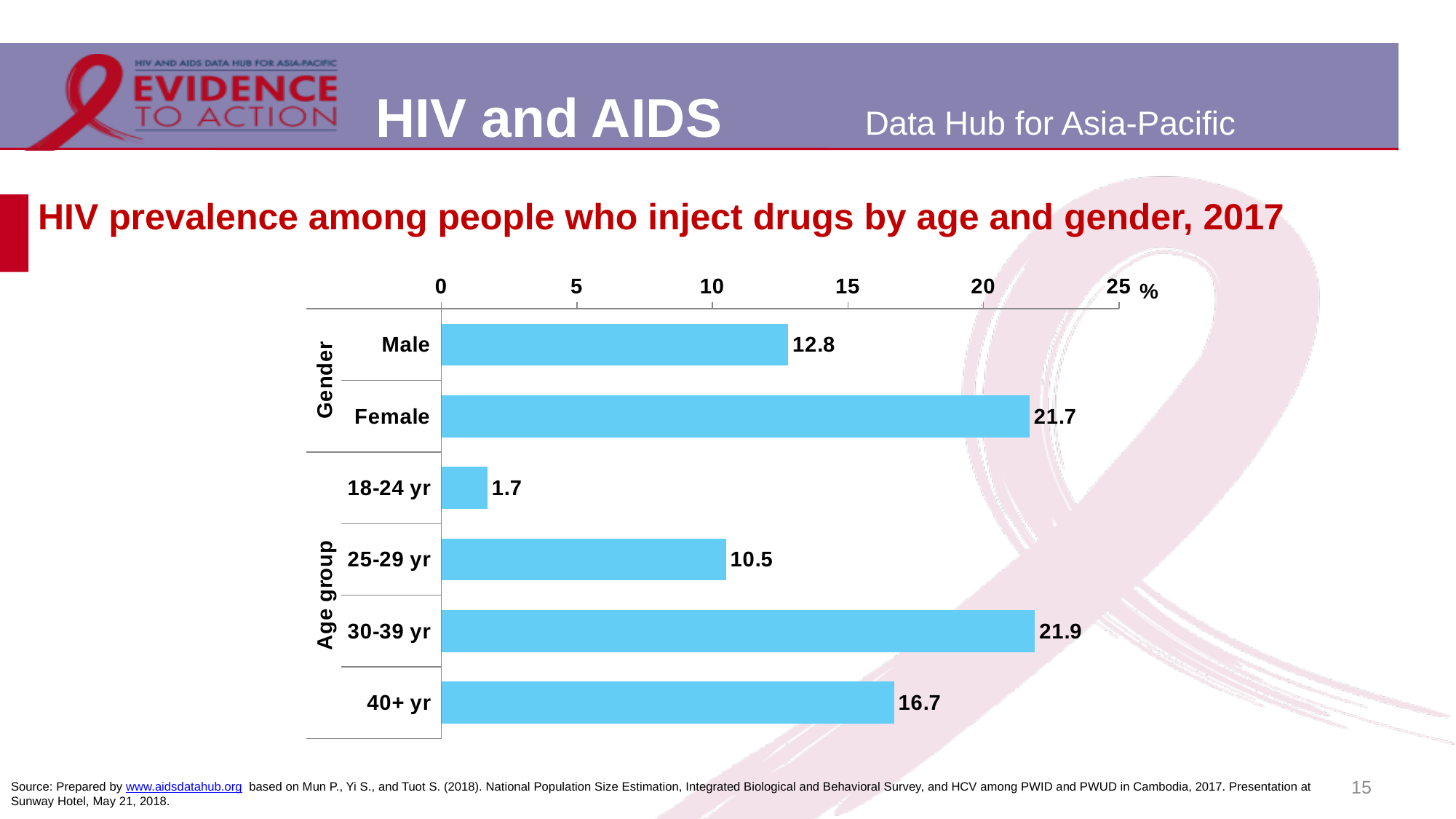
What is the HIV prevalence among female people who inject drugs? 21.7 What is the HIV prevalence among male people who inject drugs? 12.8 What is the difference in HIV prevalence between the 30-39 yr and 25-29 yr age groups? 11.4 What unit is shown at the end of the horizontal axis? % What kind of chart is shown on the slide? Bar chart What is the HIV prevalence for the 18-24 yr age group? 1.7 Which age group has the highest HIV prevalence? 30-39 yr What is the difference in HIV prevalence between female and male people who inject drugs? 8.9 Which has a higher HIV prevalence, the 25-29 yr group or the 40+ yr group? 40+ yr Which category has the lowest HIV prevalence on the chart? 18-24 yr What is the HIV prevalence for the 40+ yr age group? 16.7 How many categories (bars) are shown on the chart? 6